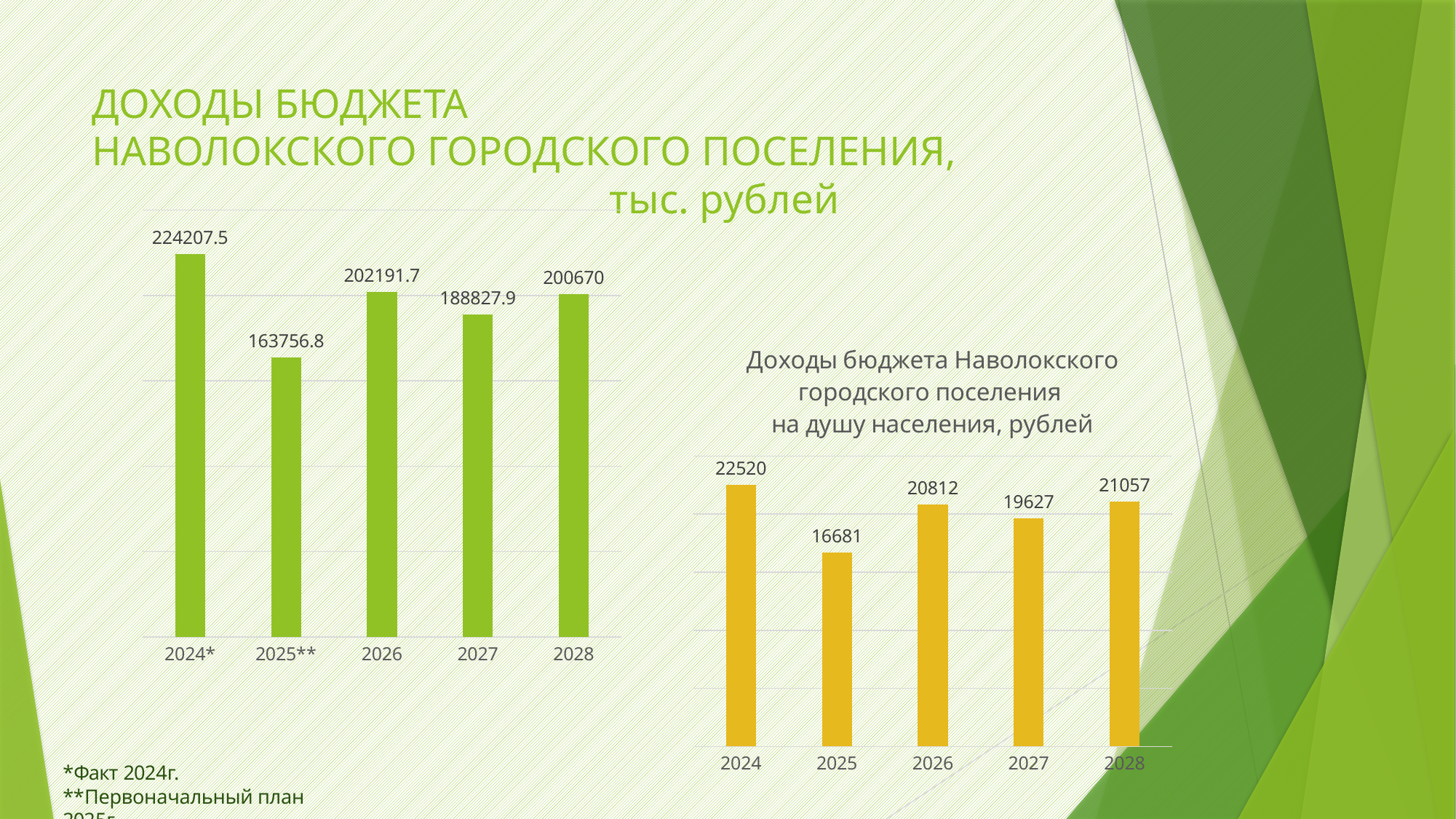
How many bars are in the left chart (budget revenues, thousand rubles)? 5 In the left chart (budget revenues, thousand rubles), which is larger: the value for 2027 or the value for 2028? 2028 What type of chart is the right chart (per capita budget revenues, rubles)? Bar chart In the right chart (per capita budget revenues, rubles), what is the difference between the 2028 value and the 2027 value? 1430 In the left chart (budget revenues, thousand rubles), which year has the lowest value? 2025** In the left chart (budget revenues, thousand rubles), what is the difference between the 2024* value and the 2025** value? 60450.7 In the right chart (per capita budget revenues, rubles), which year has the highest value? 2024 In the right chart (per capita budget revenues, rubles), which year has the lowest value? 2025 In the left chart (budget revenues, thousand rubles), what is the value for 2026? 202191.7 In the left chart (budget revenues, thousand rubles), which year has the highest value? 2024* What colour are the bars in the right chart (per capita budget revenues, rubles)? Yellow In the right chart (per capita budget revenues, rubles), what is the value for 2027? 19627